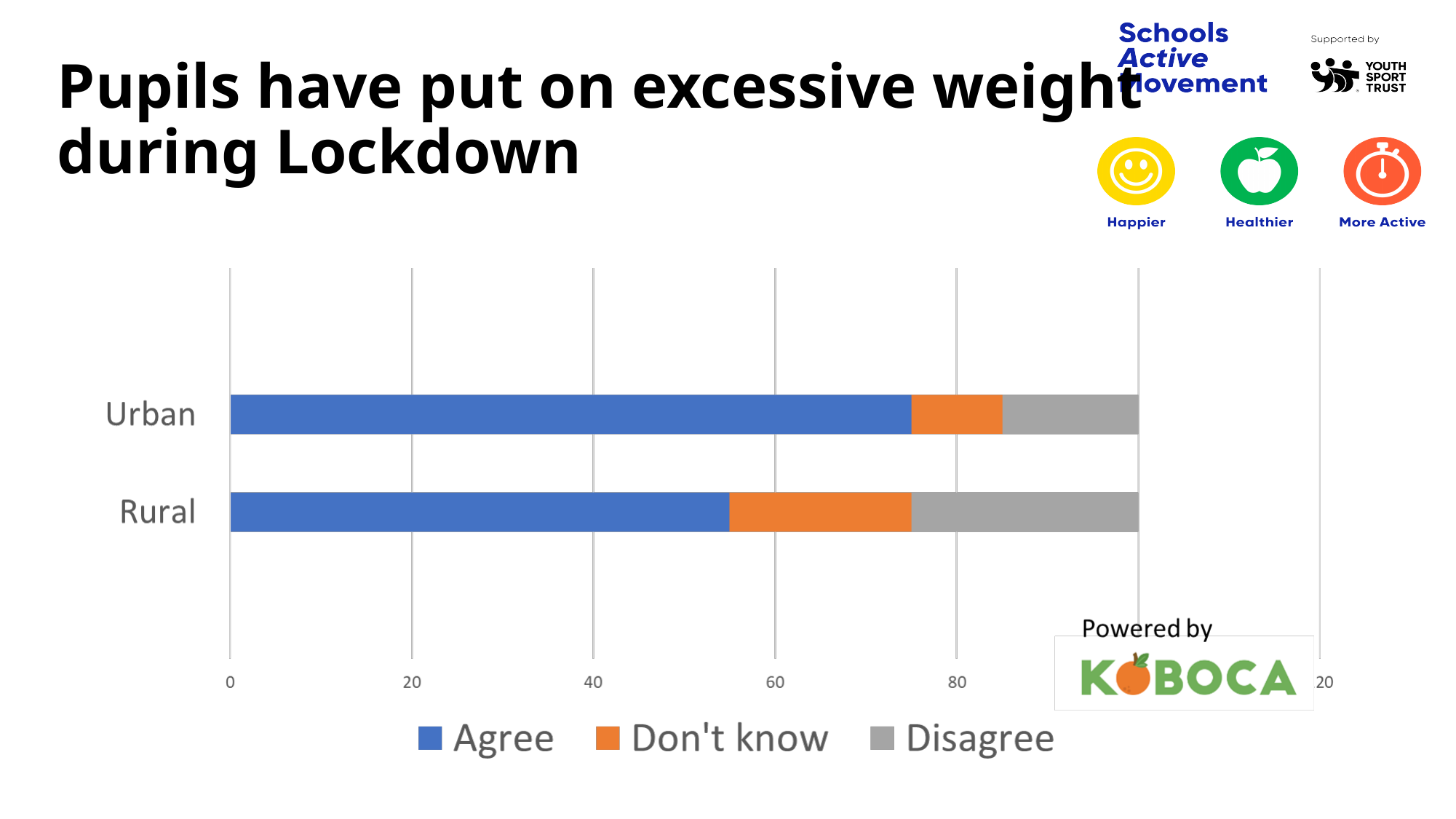
What kind of chart is shown on the slide? bar chart Is the Agree value for Rural greater or less than 60? less Which category has the larger Don't know value, Urban or Rural? Rural Is the Agree value for Rural greater or less than 40? greater What is the title of the slide containing the chart? Pupils have put on excessive weight during Lockdown How many categories are plotted on the chart? 2 Is the Agree value for Urban greater or less than 60? greater Which series is shown in orange in the chart's legend? Don't know Which category has the larger Disagree value, Urban or Rural? Rural Which category has the highest Agree value? Urban Which category has the larger Agree value, Urban or Rural? Urban How many series does the chart's legend list? 3